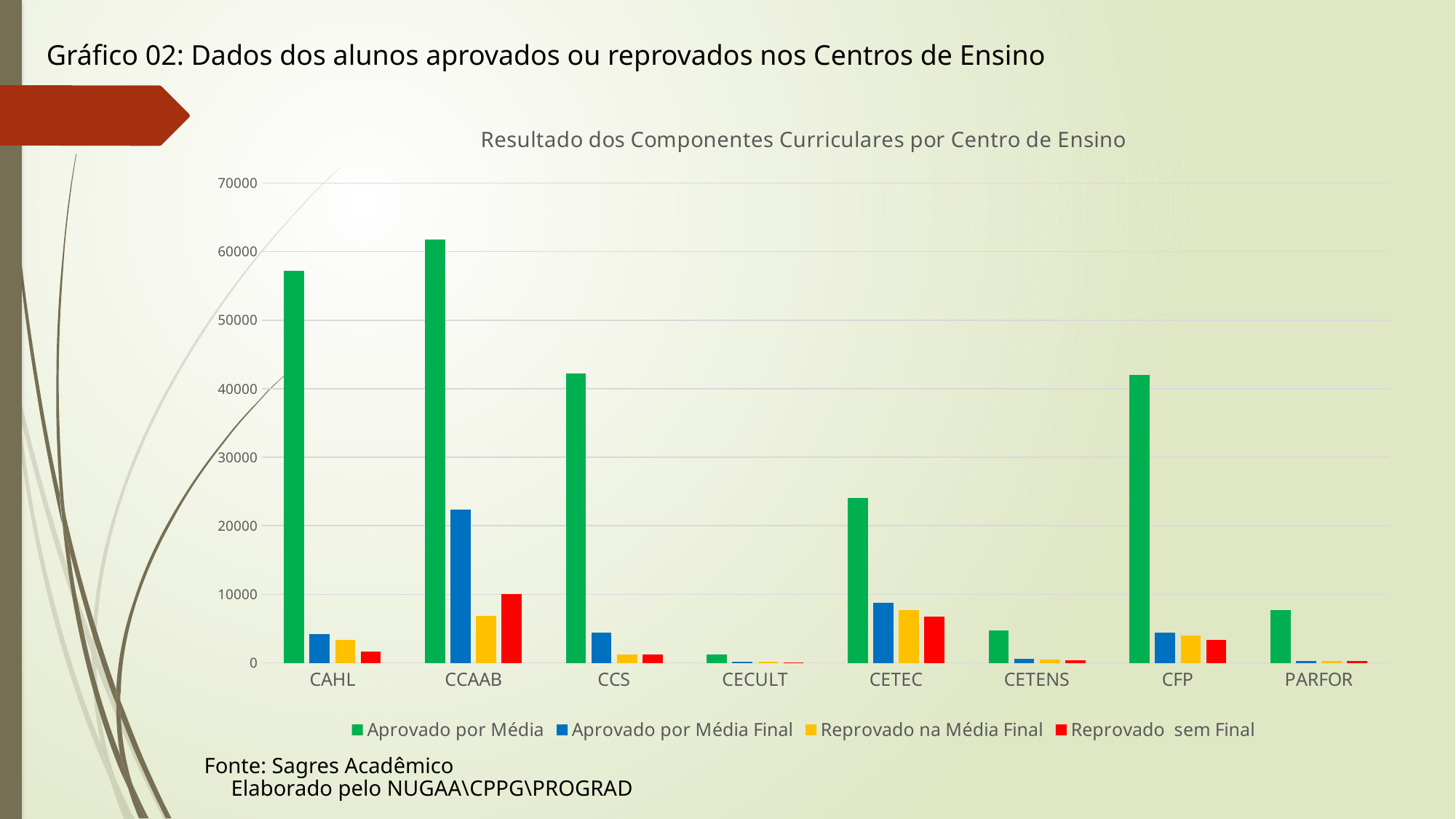
Is the Aprovado por Média Final value for CCAAB greater or less than 20000? greater Which centro de ensino has the highest value for Aprovado por Média? CCAAB How many centros de ensino (categories) are shown on the x axis? 8 Which centro de ensino has the lowest value for Aprovado por Média? CECULT What kind of chart is shown on the slide? bar chart How many series does the legend list? 4 What is the title of the chart? Resultado dos Componentes Curriculares por Centro de Ensino Which is larger: the Aprovado por Média value for CAHL or for CCS? CAHL Is the Aprovado por Média value for CCAAB greater or less than 60000? greater Is the Aprovado por Média value for CAHL greater or less than 50000? greater Which centro de ensino has the highest value for Aprovado por Média Final? CCAAB